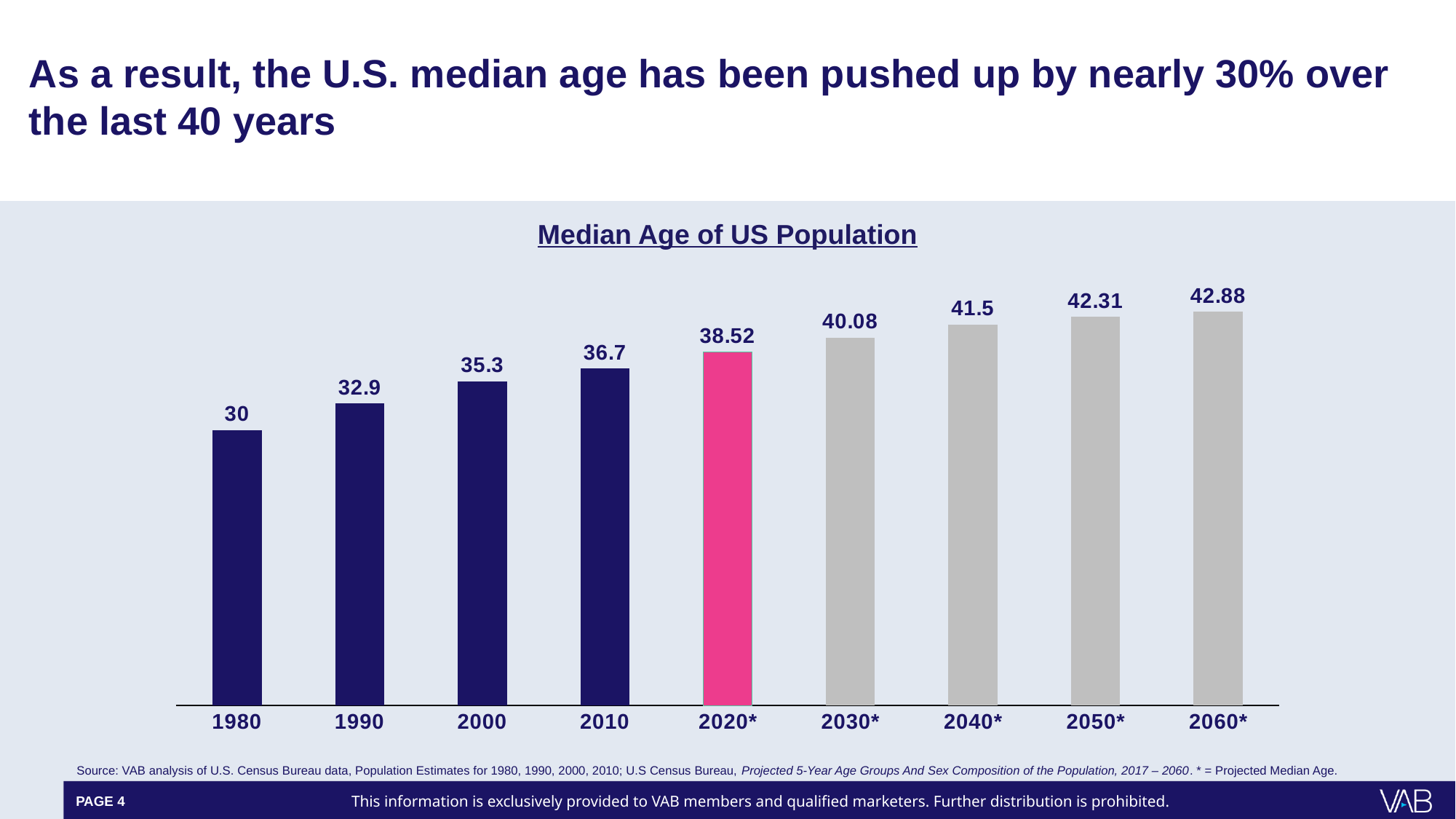
Which year has the lowest median age on the chart? 1980 What is the title of the chart? Median Age of US Population Which year has the highest median age on the chart? 2060* Which is larger, the value for 2000 or the value for 2030*? 2030* What value is shown for 2020*? 38.52 How many years (bars) are shown on the chart? 9 What is the difference between the median age in 2010 and in 1980? 6.7 Do the median age values rise or fall from 1980 to 2060*? Rise What is the median age of the US population shown for 1980? 30 What is the difference between the values for 2050* and 2040*? 0.81 What is the projected median age shown for 2060*? 42.88 What kind of chart is used to show the median age of the US population? Bar chart